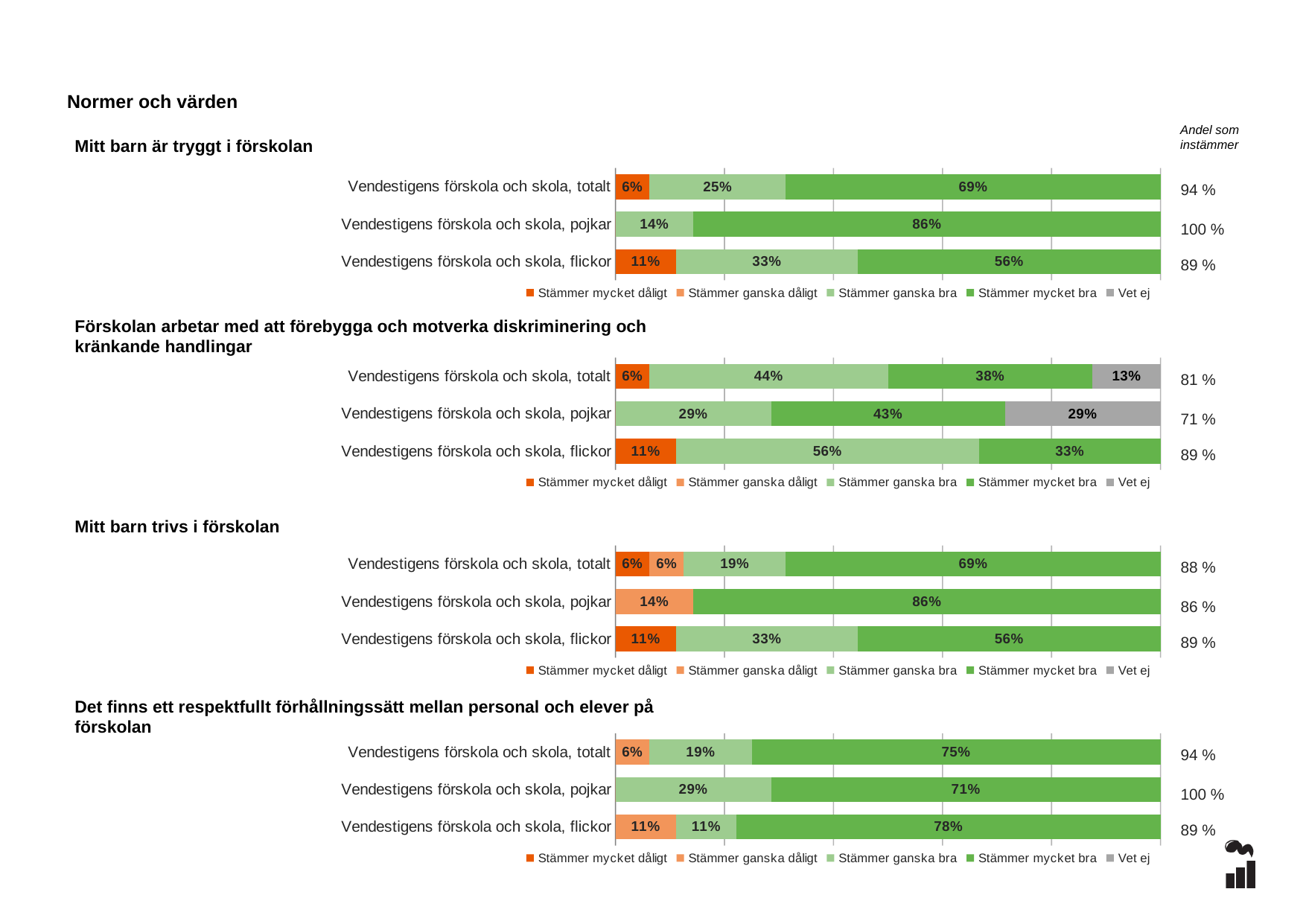
In the chart 'Mitt barn trivs i förskolan', what is the difference between the 'Stämmer mycket bra' values for pojkar and flickor? 30% How many series does the legend of the chart 'Mitt barn trivs i förskolan' list? 5 In the chart 'Det finns ett respektfullt förhållningssätt mellan personal och elever på förskolan', which is larger: the 'Stämmer mycket bra' value for totalt or for pojkar? totalt In the chart 'Mitt barn är tryggt i förskolan', what is the 'Stämmer ganska bra' value for Vendestigens förskola och skola, flickor? 33% In the chart 'Förskolan arbetar med att förebygga och motverka diskriminering och kränkande handlingar', what is the 'Vet ej' value for Vendestigens förskola och skola, pojkar? 29% How many categories (bars) does the chart 'Mitt barn är tryggt i förskolan' show? 3 In the chart 'Det finns ett respektfullt förhållningssätt mellan personal och elever på förskolan', what is the 'Stämmer mycket bra' value for Vendestigens förskola och skola, flickor? 78% What kind of chart is 'Det finns ett respektfullt förhållningssätt mellan personal och elever på förskolan'? Stacked bar chart In the chart 'Förskolan arbetar med att förebygga och motverka diskriminering och kränkande handlingar', which category has the highest 'Stämmer ganska bra' value? Vendestigens förskola och skola, flickor In the chart 'Mitt barn är tryggt i förskolan', what is the 'Stämmer mycket bra' value for Vendestigens förskola och skola, pojkar? 86% In the chart 'Förskolan arbetar med att förebygga och motverka diskriminering och kränkande handlingar', which category has the lowest 'Stämmer mycket bra' value? Vendestigens förskola och skola, flickor In the chart 'Mitt barn trivs i förskolan', what is the 'Stämmer ganska dåligt' value for Vendestigens förskola och skola, pojkar? 14%